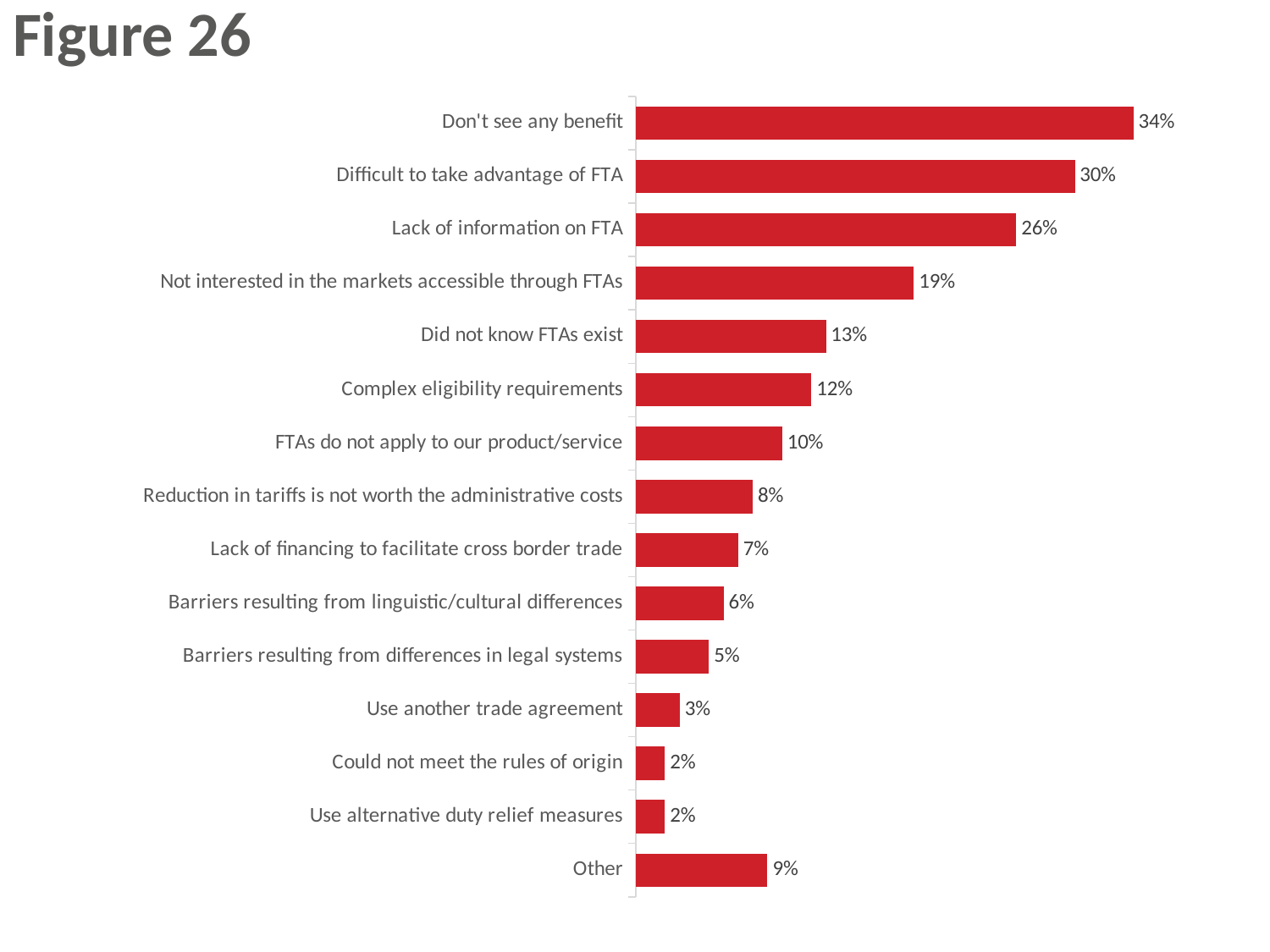
Which is larger, "Other" or "Reduction in tariffs is not worth the administrative costs"? Other What is the value for "Lack of information on FTA"? 26% What is the value for "Other"? 9% Which is larger, "Not interested in the markets accessible through FTAs" or "Did not know FTAs exist"? Not interested in the markets accessible through FTAs What is the difference between "Did not know FTAs exist" and "Complex eligibility requirements"? 1% What is the title of the slide? Figure 26 What is the value for "Use another trade agreement"? 3% Which category has the highest value? Don't see any benefit What is the difference between "Difficult to take advantage of FTA" and "Lack of information on FTA"? 4% What kind of chart is shown on the slide? Bar chart How many categories are shown in the chart? 15 What is the value for "Don't see any benefit"? 34%